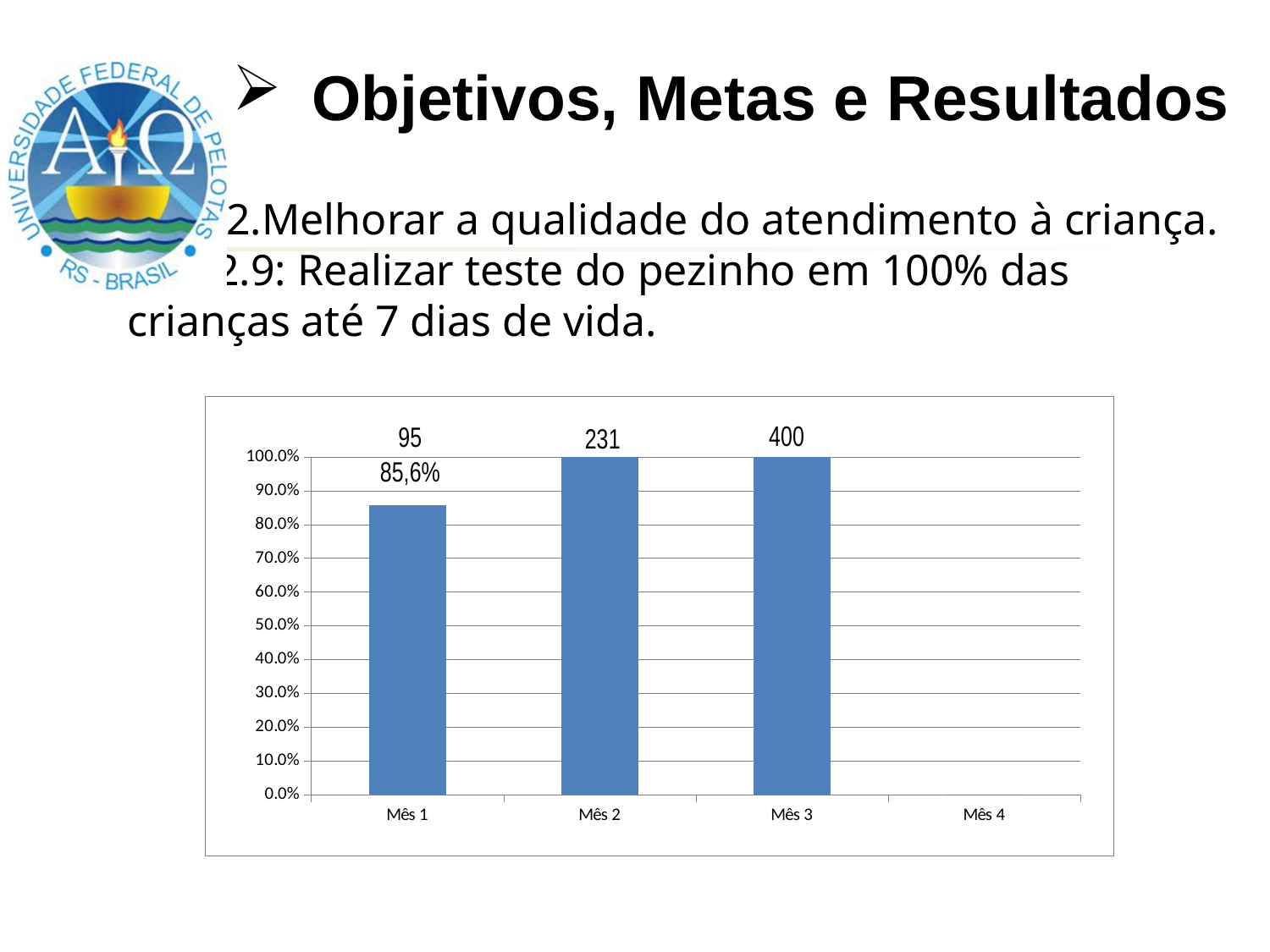
Is the value for Mês 1 greater or less than 90.0%? less What is the difference between the values for Mês 2 and Mês 1? 14.4 percentage points Which month on the x axis has no bar plotted? Mês 4 What is the value for Mês 1? 85,6% What kind of chart is shown on the slide? Bar chart What number is printed above the bar for Mês 3? 400 Do the values rise or fall from Mês 1 to Mês 3? Rise Which of Mês 1 and Mês 2 has the larger value? Mês 2 What is the value for Mês 3? 100.0% How many categories are shown on the x axis? 4 What is the value for Mês 2? 100.0% Is the value for Mês 1 greater or less than 80.0%? greater